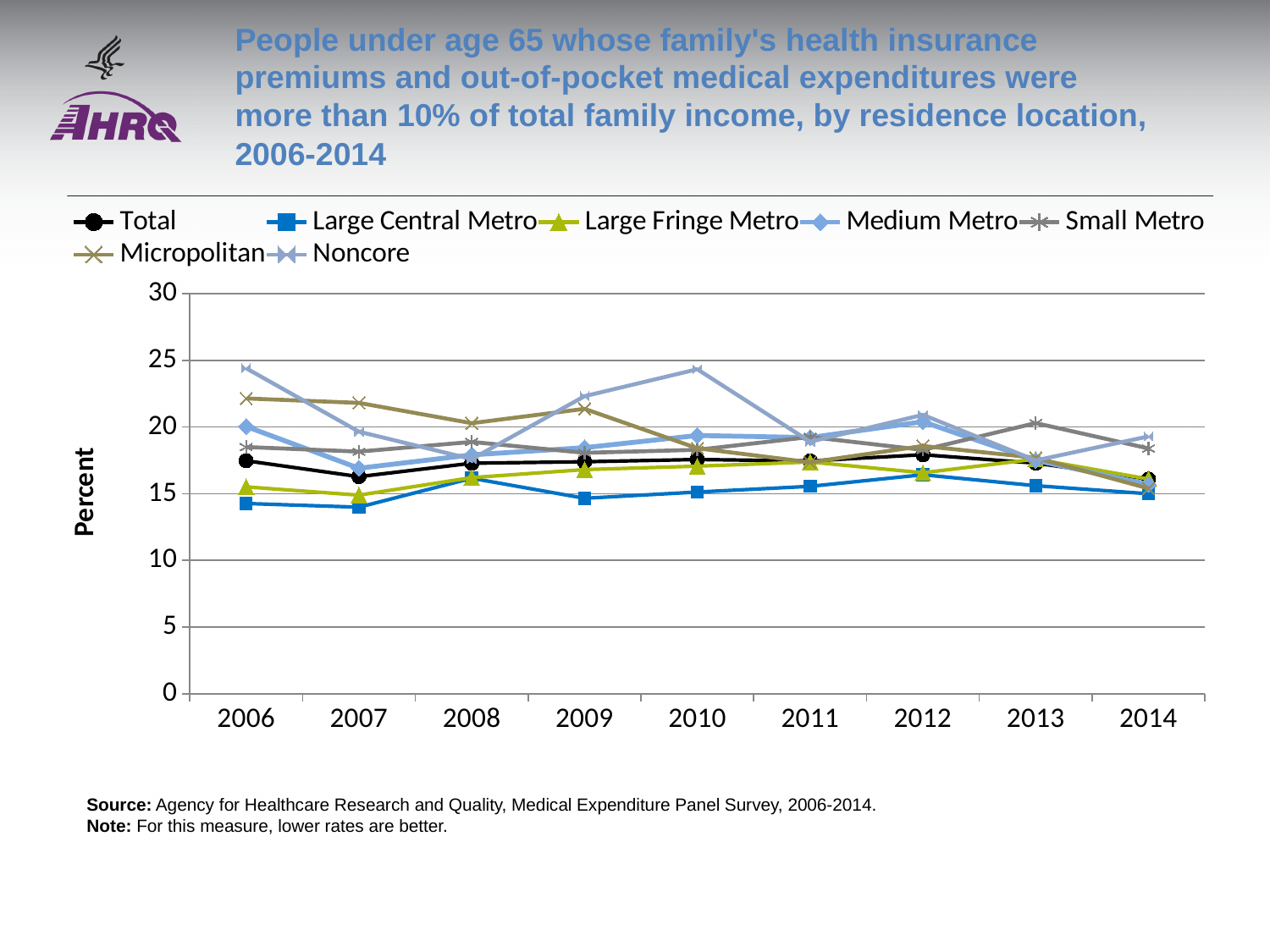
What type of chart is shown on the slide? Line chart Is the value for Noncore in 2006 greater or less than 20? greater In 2010, which was larger: the value for Noncore or the value for Large Central Metro? Noncore Which residence location had the highest value in 2006? Noncore Is the value for Micropolitan in 2006 greater or less than 20? greater What is the label on the y axis? Percent Is the value for Total in 2014 greater or less than 20? less How many series does the legend list? 7 Which residence location had the highest value in 2010? Noncore How many years are plotted along the x axis? 9 Which residence location had the lowest value in 2006? Large Central Metro